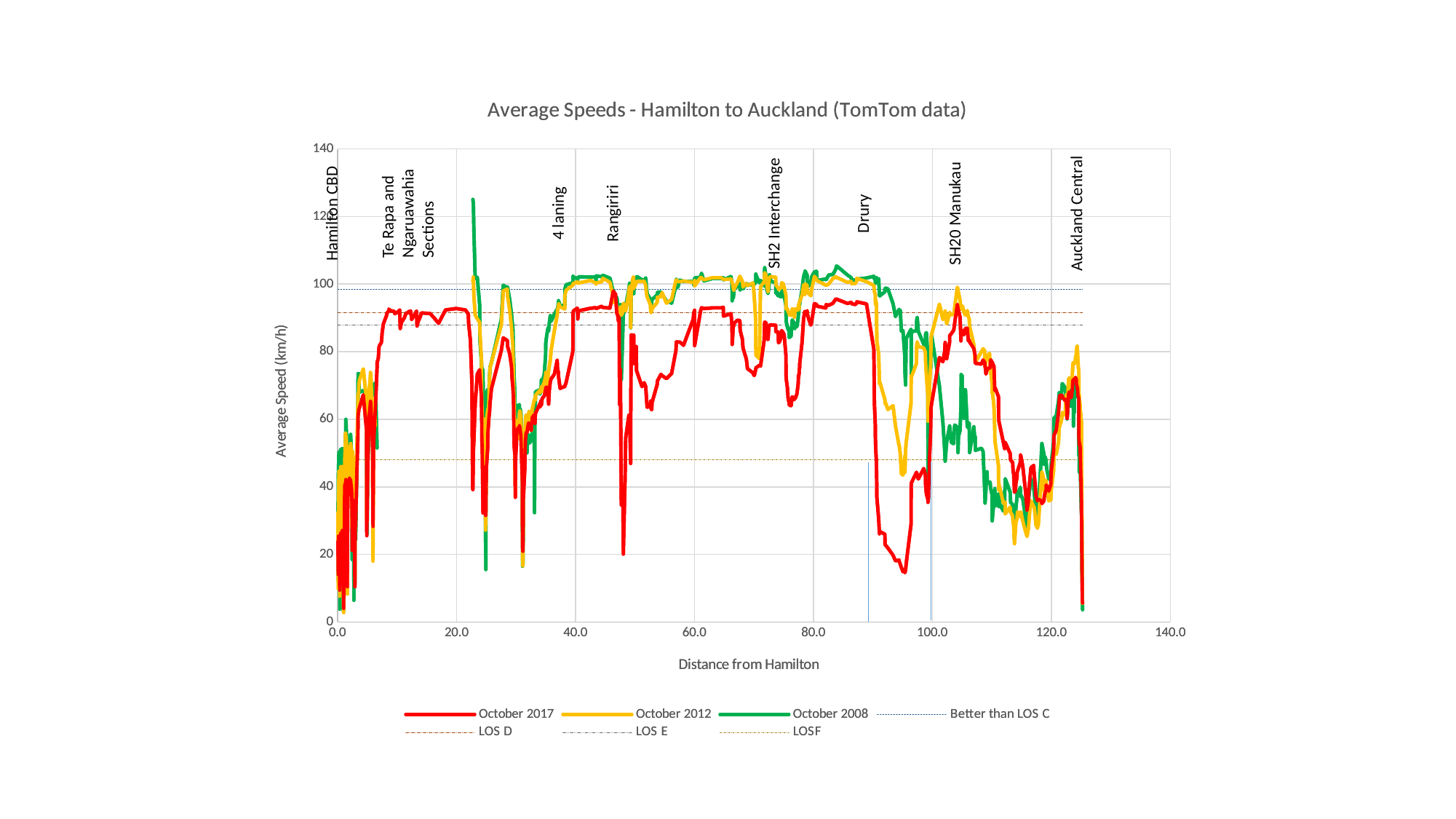
What is the title of the chart? Average Speeds - Hamilton to Auckland (TomTom data) How many entries does the legend list? 7 At about 95 km from Hamilton, which series is higher: October 2017 or October 2008? October 2008 Is the October 2008 value at about 110 km from Hamilton greater or less than 60? less Is the October 2017 value at about 95 km from Hamilton greater or less than 40? less Which of the three October series is highest at about 95 km from Hamilton? October 2008 At about 110 km from Hamilton, which series is higher: October 2017 or October 2008? October 2017 What kind of chart is shown on the slide? line chart Is the October 2017 value at about 110 km from Hamilton greater or less than 60? greater What is the label of the x axis? Distance from Hamilton Does the October 2017 line rise or fall between about 90 km and 95 km from Hamilton? fall